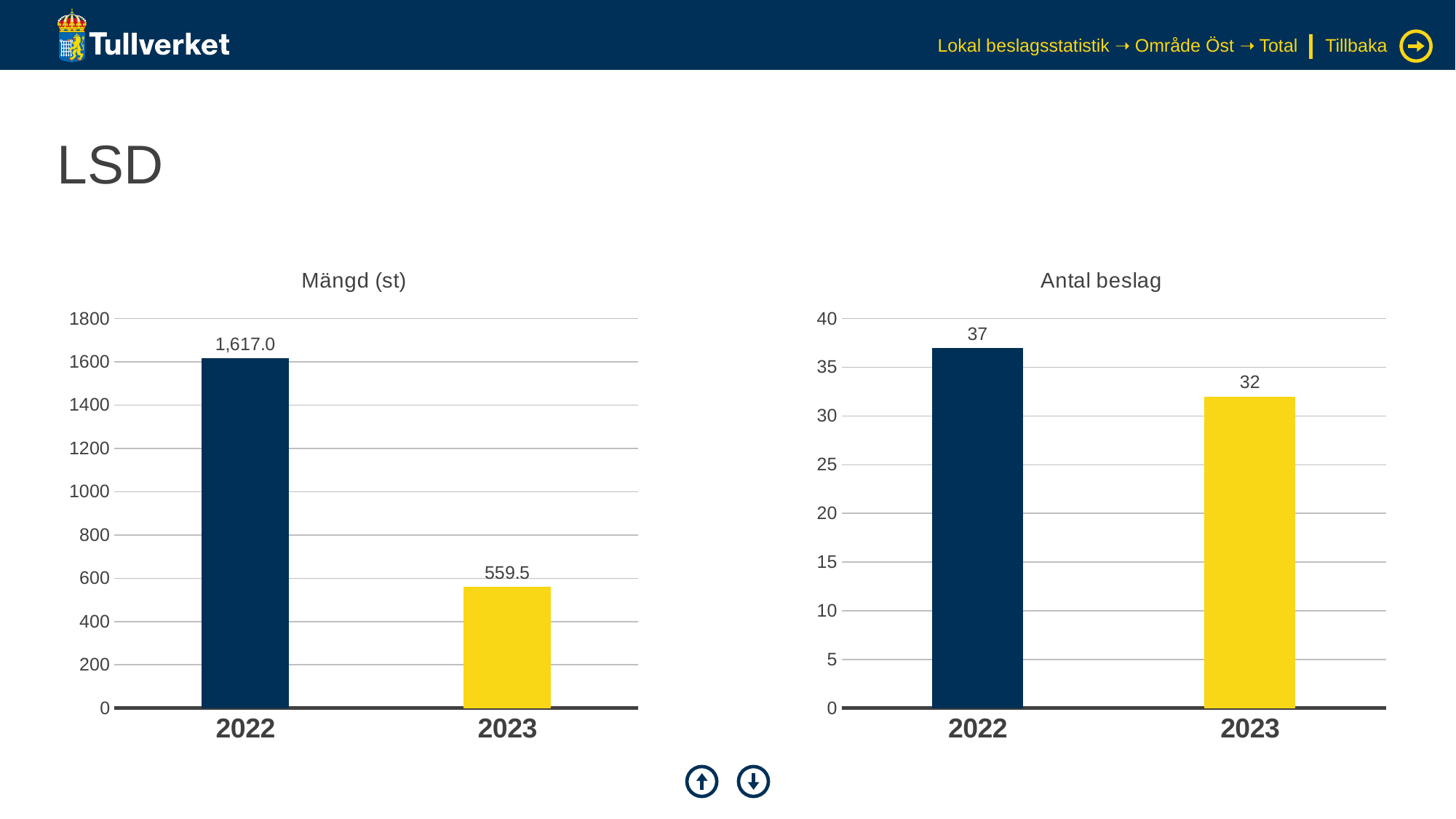
In the "Mängd (st)" chart, is the value for 2023 greater or less than 600? less What kind of chart is the "Mängd (st)" chart? bar chart In the "Mängd (st)" chart, what is the value for 2022? 1,617.0 In the "Antal beslag" chart, what is the difference between the 2022 and 2023 values? 5 In the "Antal beslag" chart, what is the value for 2022? 37 In the "Mängd (st)" chart, what is the value for 2023? 559.5 In the "Antal beslag" chart, what is the value for 2023? 32 In the "Antal beslag" chart, which year has the lowest value? 2023 How many categories are shown in the "Antal beslag" chart? 2 In the "Mängd (st)" chart, which year has the highest value? 2022 In the "Antal beslag" chart, which is larger, the value for 2022 or 2023? 2022 In the "Mängd (st)" chart, what is the difference between the 2022 and 2023 values? 1,057.5